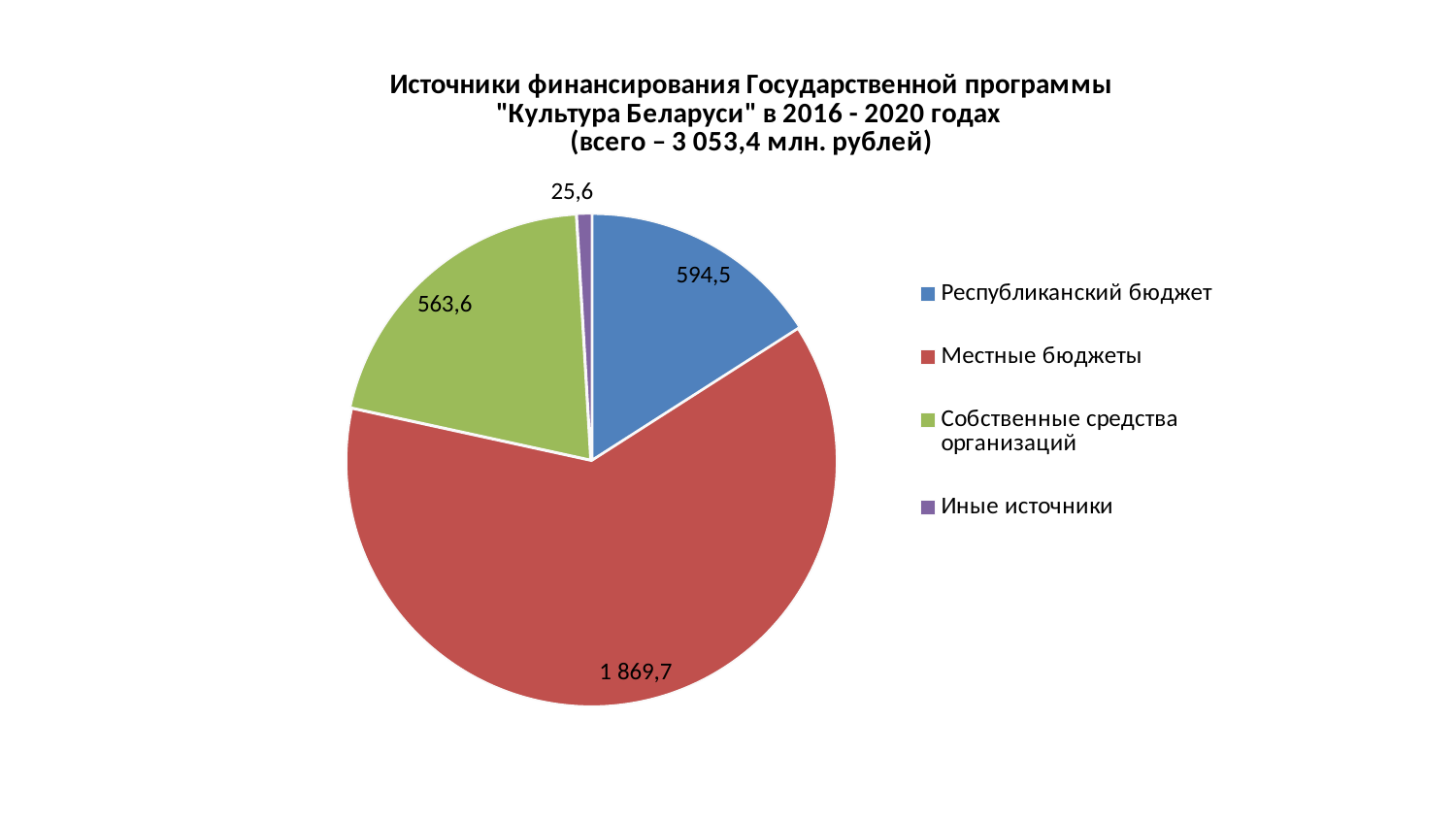
What is the value for Местные бюджеты? 1 869,7 What is the value for Иные источники? 25,6 Which funding source has the largest slice? Местные бюджеты Which is larger, Республиканский бюджет or Собственные средства организаций? Республиканский бюджет What is the value for Республиканский бюджет? 594,5 What is the difference between Местные бюджеты and Республиканский бюджет? 1 275,2 What kind of chart is shown on the slide? Pie chart Which funding source has the smallest slice? Иные источники How many slices does the pie chart have? 4 What is the difference between Республиканский бюджет and Собственные средства организаций? 30,9 What is the value for Собственные средства организаций? 563,6 What total amount is stated in the chart title? 3 053,4 млн. рублей